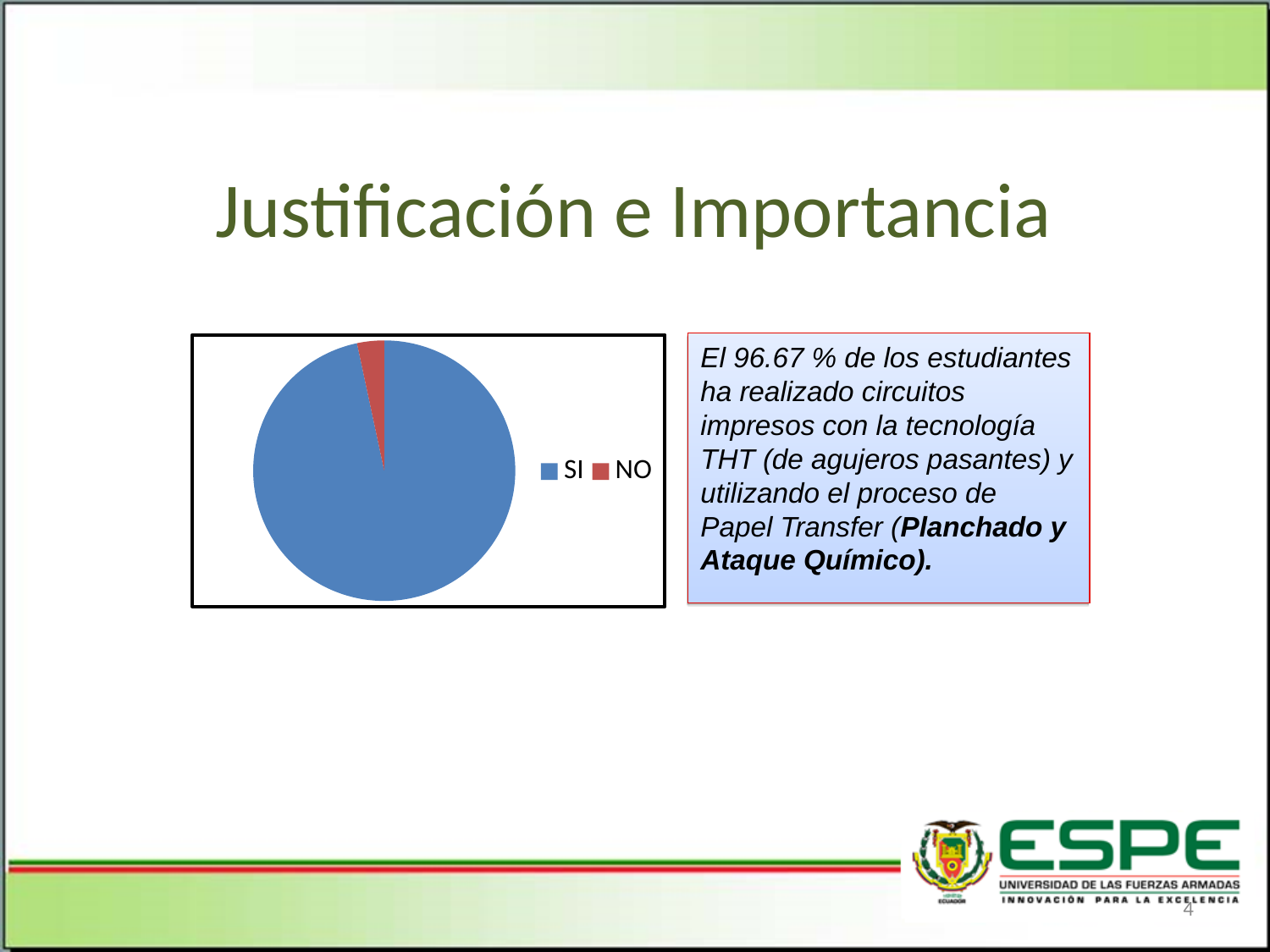
Which category has the largest slice in the pie chart? SI What kind of chart is shown on the slide? pie chart Which slice is larger in the pie chart, SI or NO? SI What colour is the NO slice in the pie chart? red How many entries does the legend of the pie chart list? 2 Which category has the smallest slice in the pie chart? NO What colour is the SI slice in the pie chart? blue Does the SI slice take up more or less than half of the pie chart? more How many slices does the pie chart have? 2